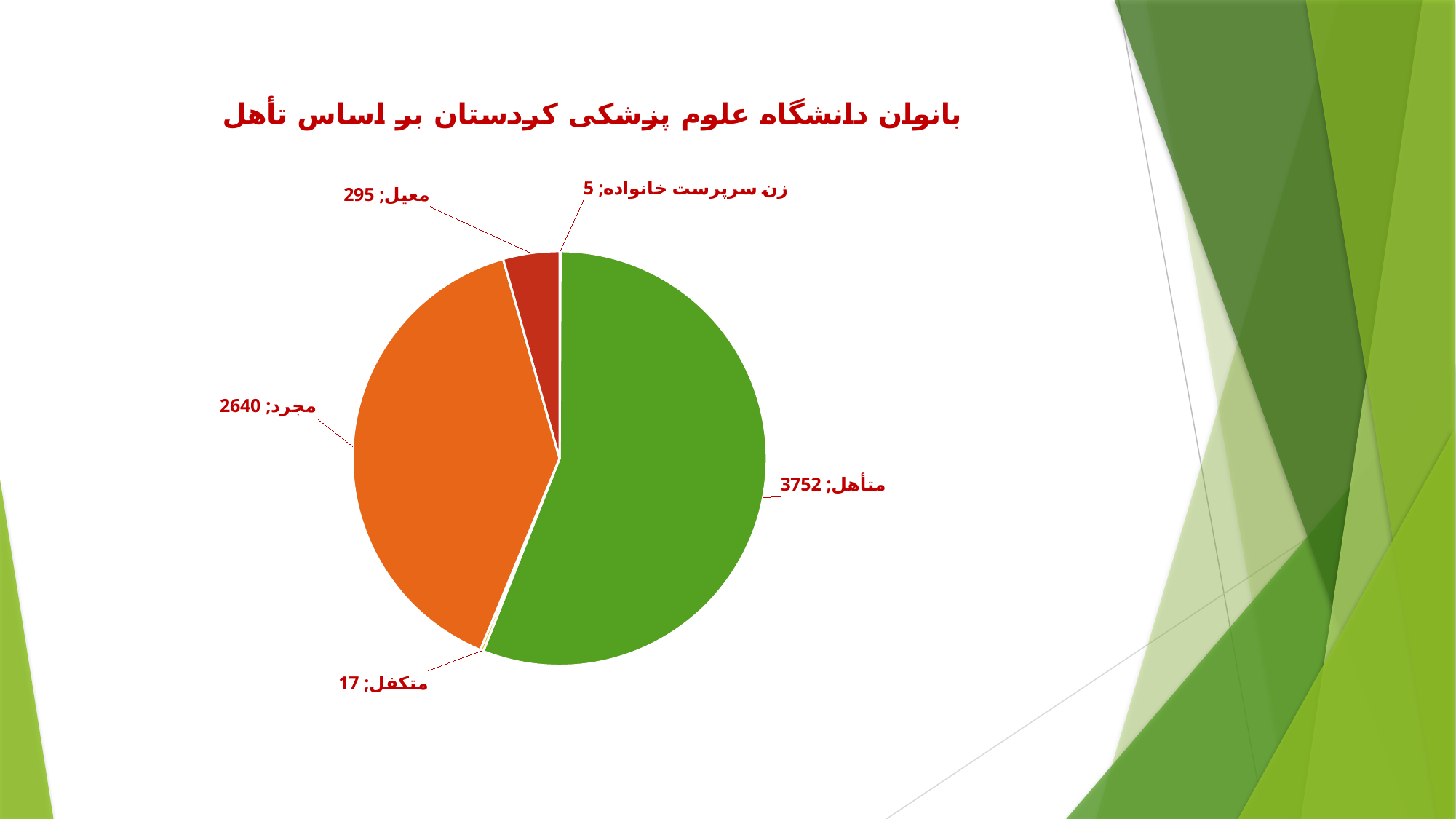
Which is larger, the value for مجرد or the value for معیل? مجرد What colour is the slice for مجرد? orange Which category has the largest slice of the pie? متأهل What is the value for معیل in the pie chart? 295 What is the value for متأهل in the pie chart? 3752 What is the value for مجرد in the pie chart? 2640 What is the difference between the values for معیل and متکفل? 278 What type of chart is shown on the slide? pie chart Which category has the smallest slice of the pie? زن سرپرست خانواده What is the difference between the values for متأهل and مجرد? 1112 How many categories are shown in the pie chart? 5 What is the value for زن سرپرست خانواده in the pie chart? 5